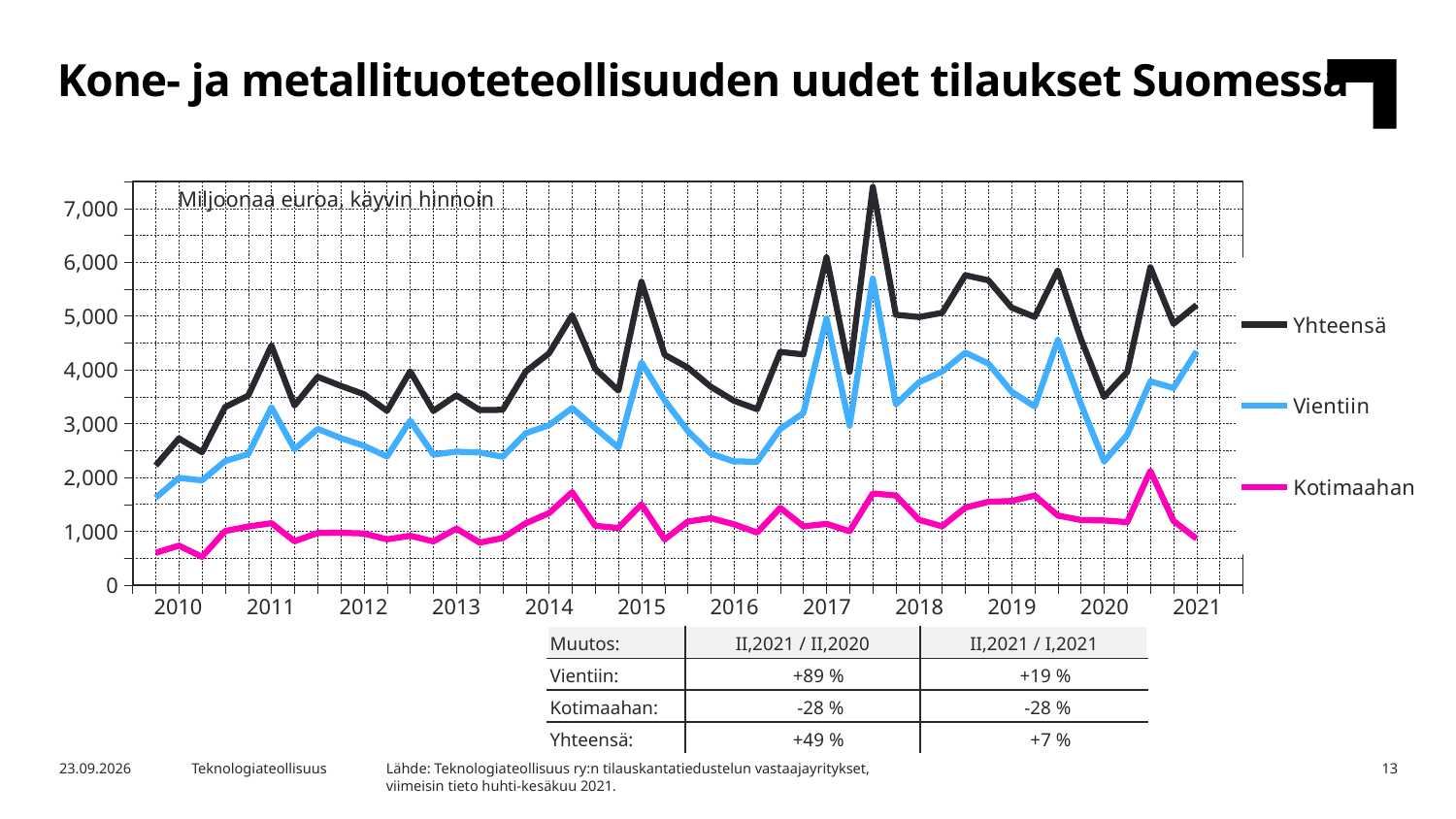
Which series has the lowest values throughout the chart? Kotimaahan Is the value for Kotimaahan at any point greater or less than 3,000? less Which series is larger in 2021, Vientiin or Kotimaahan? Vientiin Is the first value for Vientiin in 2010 greater or less than 2,000? less What are the names of the series in the chart legend? Yhteensä, Vientiin, Kotimaahan Is the peak value of Yhteensä in 2017 greater or less than 7,000? greater What kind of chart is shown on the slide? Line chart Which series reaches the highest value in the chart? Yhteensä How many years are labelled on the x axis of the chart? 12 Does the Yhteensä series overall rise or fall from 2010 to 2021? rise How many series does the chart legend list? 3 What unit is stated in the chart's subtitle? Miljoonaa euroa, käyvin hinnoin